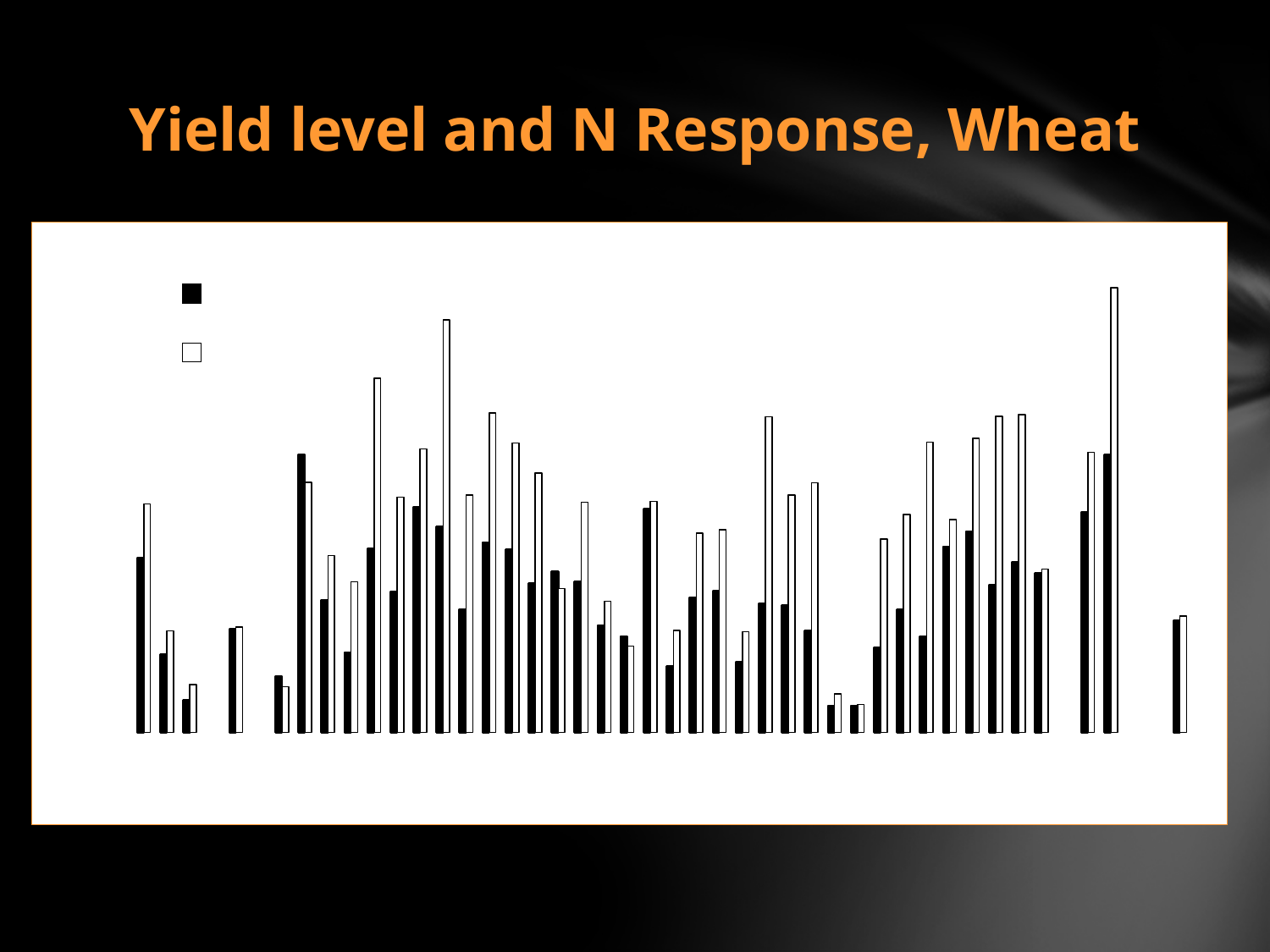
How many series does the chart's legend list? 2 Does the chart display any axis labels or data labels? No What kind of chart is shown on the slide? Bar chart What colours are used for the two series in the chart? Black and white Is the tallest bar in the chart black or white? White